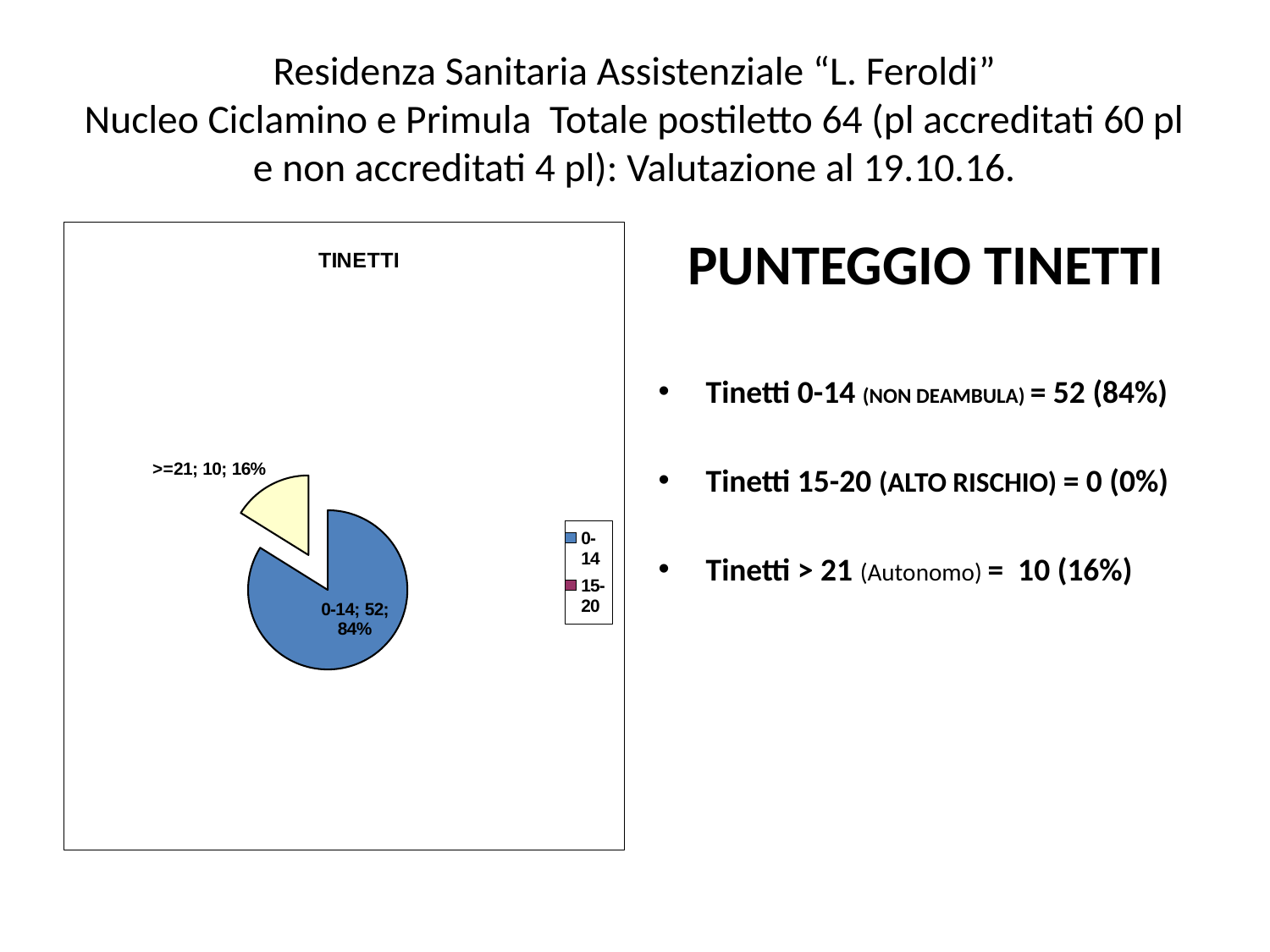
What is the title of the chart? TINETTI How many patients are in the 0-14 slice of the pie chart? 52 What share of the pie does the 0-14 slice represent? 84% How many patients are in the >=21 slice of the pie chart? 10 Which slice of the pie chart is the largest? 0-14 What kind of chart is shown on the slide? pie chart Which is larger in the pie chart, the 0-14 slice or the >=21 slice? 0-14 What share of the pie does the >=21 slice represent? 16% What colour is the 0-14 slice in the pie chart? blue Which of the labelled slices in the pie chart is the smallest? >=21 What is the difference between the 0-14 value and the >=21 value in the pie chart? 42 How many labelled slices does the pie chart show? 2